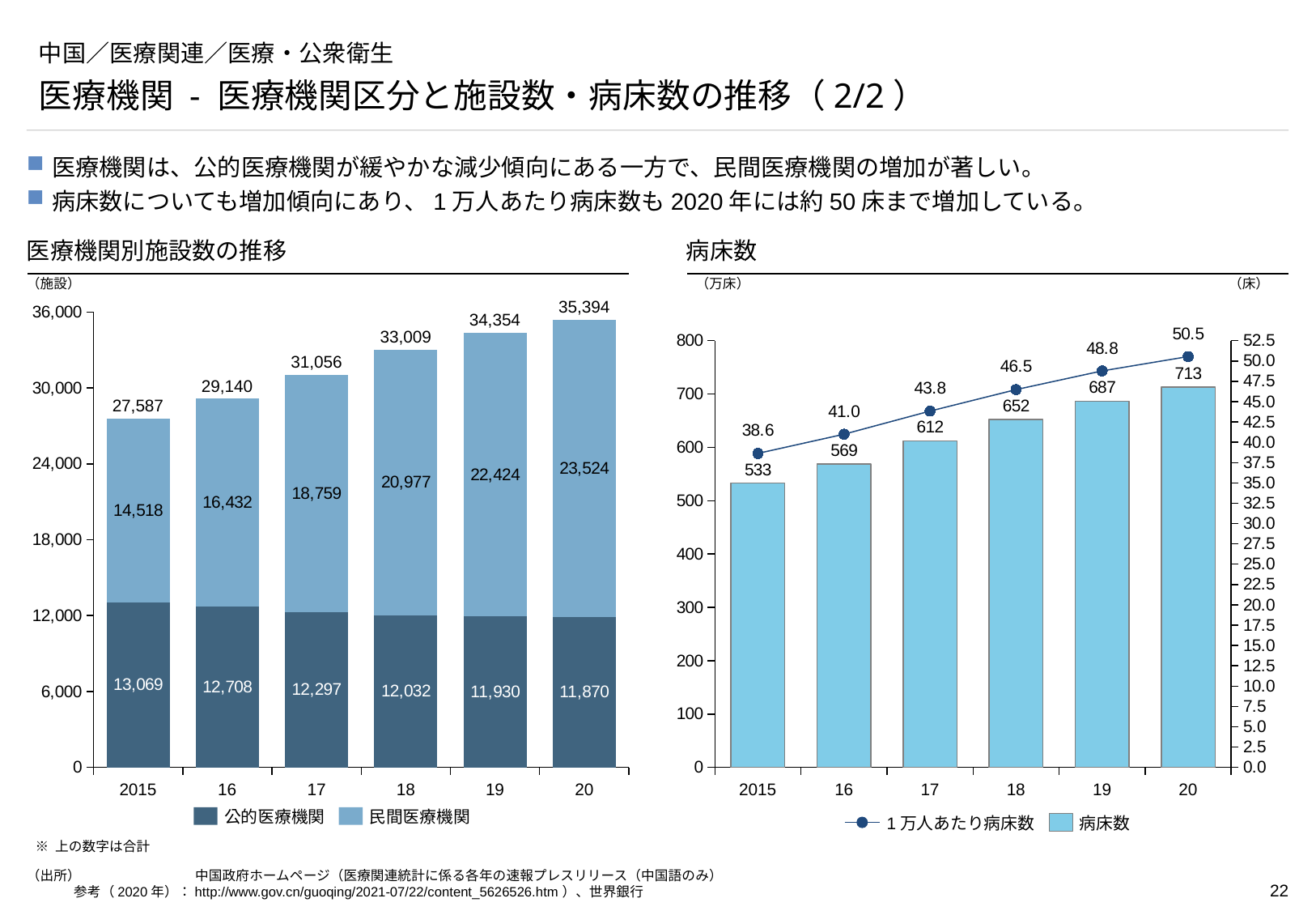
In the left chart (医療機関別施設数の推移), what is the value for 民間医療機関 in 2018? 20,977 In the left chart (医療機関別施設数の推移), what is the total of the stacked bar for 20 (2020)? 35,394 In the left chart (医療機関別施設数の推移), which year has the lowest value for 公的医療機関? 20 In the right chart (病床数), what is the difference in 病床数 between 2015 and 20? 180 In the right chart (病床数), which year has the highest 病床数? 20 In the left chart (医療機関別施設数の推移), what is the difference between the 民間医療機関 values for 2015 and 20? 9,006 In the right chart (病床数), what is the 病床数 value for 2017? 612 In the left chart (医療機関別施設数の推移), what is the value for 公的医療機関 in 2015? 13,069 In the left chart (医療機関別施設数の推移), how many series does the legend list? 2 In the left chart (医療機関別施設数の推移), does the value for 公的医療機関 rise or fall from 2015 to 20? fall In the right chart (病床数), what is the 1万人あたり病床数 value for 2019? 48.8 In the right chart (病床数), how many years are shown on the x axis? 6